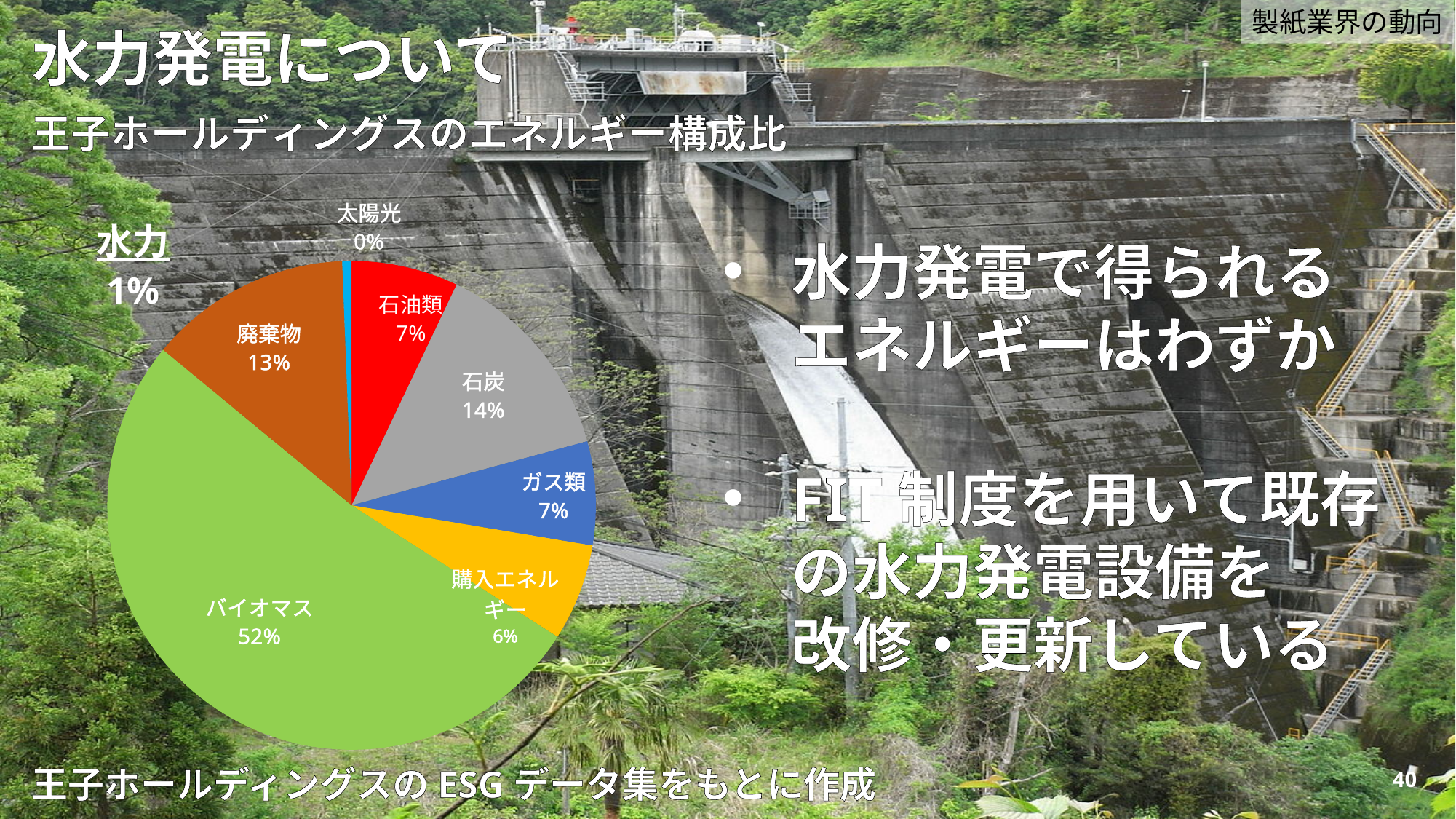
Which category has the smallest slice in the pie chart? 太陽光 What is the difference in percentage points between 石炭 and 石油類? 7 How many categories are shown in the pie chart? 8 What is the title of the chart on the slide? 王子ホールディングスのエネルギー構成比 What percentage is shown for 廃棄物 (waste) in the pie chart? 13% What is the combined share of 石油類 and ガス類 in the pie chart? 14% Which is larger in the pie chart, 廃棄物 or 購入エネルギー? 廃棄物 What percentage is shown for 水力 (hydro) in the pie chart? 1% What share of the pie chart does バイオマス (biomass) account for? 52% What kind of chart is shown on the slide? Pie chart Which category has the largest slice in the pie chart? バイオマス What is the value shown for 石炭 (coal) in the pie chart? 14%